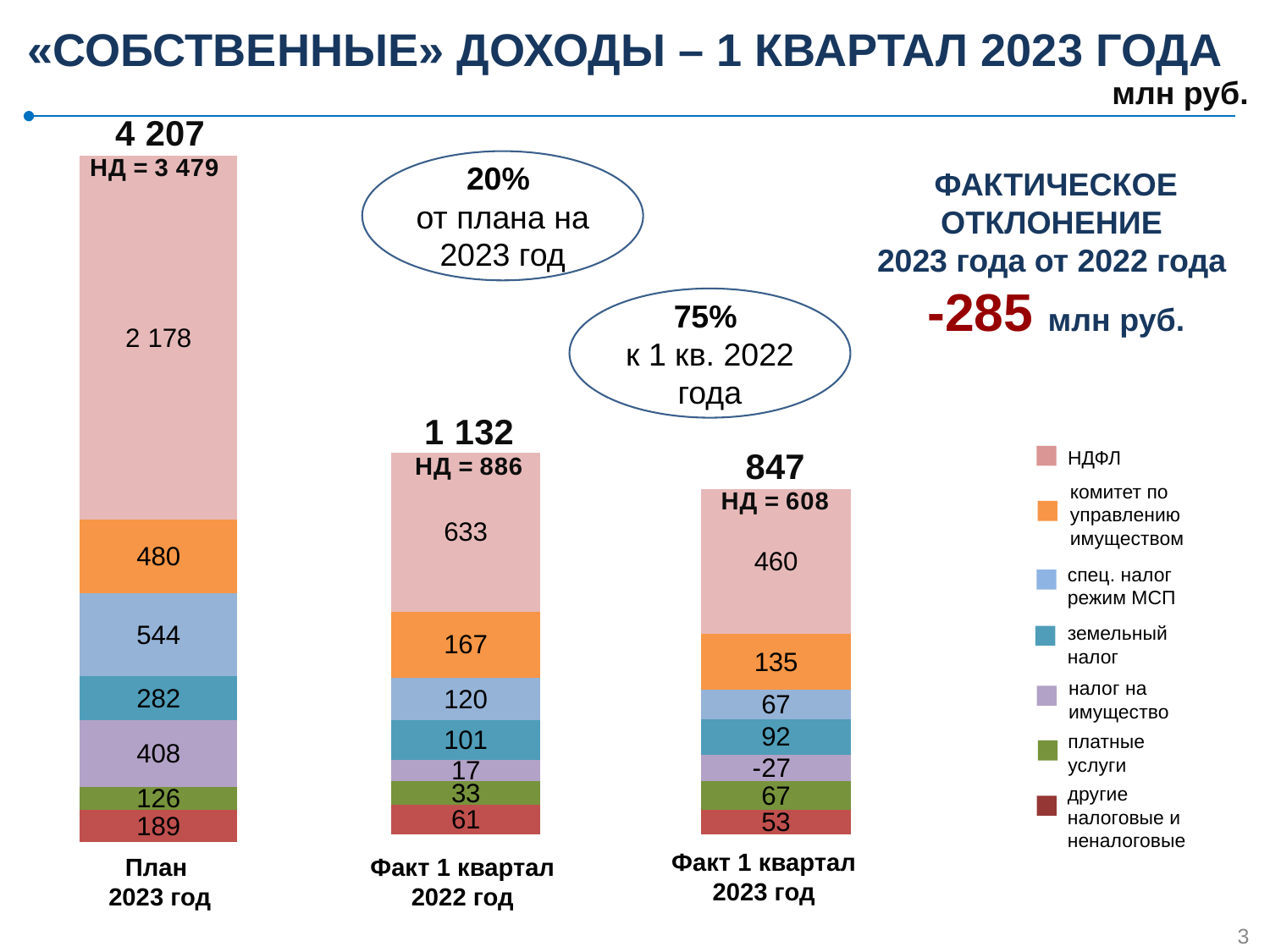
Which bar has the highest total? План 2023 год What is the total of the План 2023 год stacked bar? 4 207 Which bar has the lowest total? Факт 1 квартал 2023 год What is the НДФЛ value for the План 2023 год bar? 2 178 Which is larger: земельный налог for Факт 1 квартал 2022 год or for Факт 1 квартал 2023 год? Факт 1 квартал 2022 год What is the value of комитет по управлению имуществом for Факт 1 квартал 2022 год? 167 What is the total of the Факт 1 квартал 2023 год stacked bar? 847 What is the difference between the НДФЛ values for Факт 1 квартал 2022 год and Факт 1 квартал 2023 год? 173 What kind of chart is shown on the slide? Stacked bar chart How many bars (categories) are shown in the chart? 3 What is the налог на имущество value for Факт 1 квартал 2023 год? -27 How many series does the legend list? 7